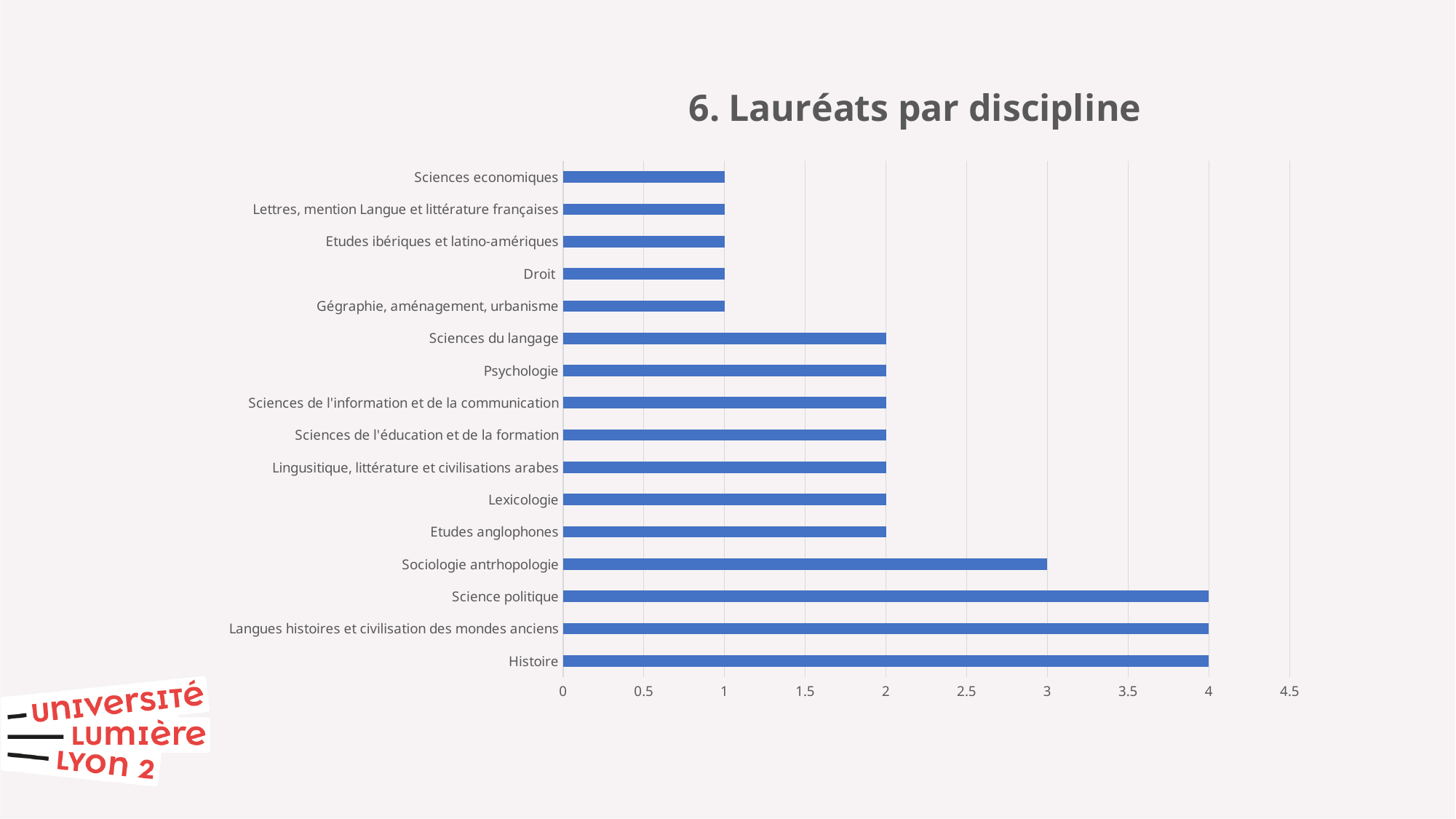
What is the difference between the values for Histoire and Droit? 3 What is the difference between the values for Science politique and Sociologie antrhopologie? 1 What is the value for Histoire? 4 What is the title of the chart? 6. Lauréats par discipline Which has a larger value, Sciences du langage or Sciences economiques? Sciences du langage Is the value for Sociologie antrhopologie greater or less than 2? greater What type of chart is shown on the slide? bar chart What is the value for Sociologie antrhopologie? 3 How many disciplines are listed on the chart? 16 What is the value for Science politique? 4 What is the value for Psychologie? 2 What is the value for Droit? 1